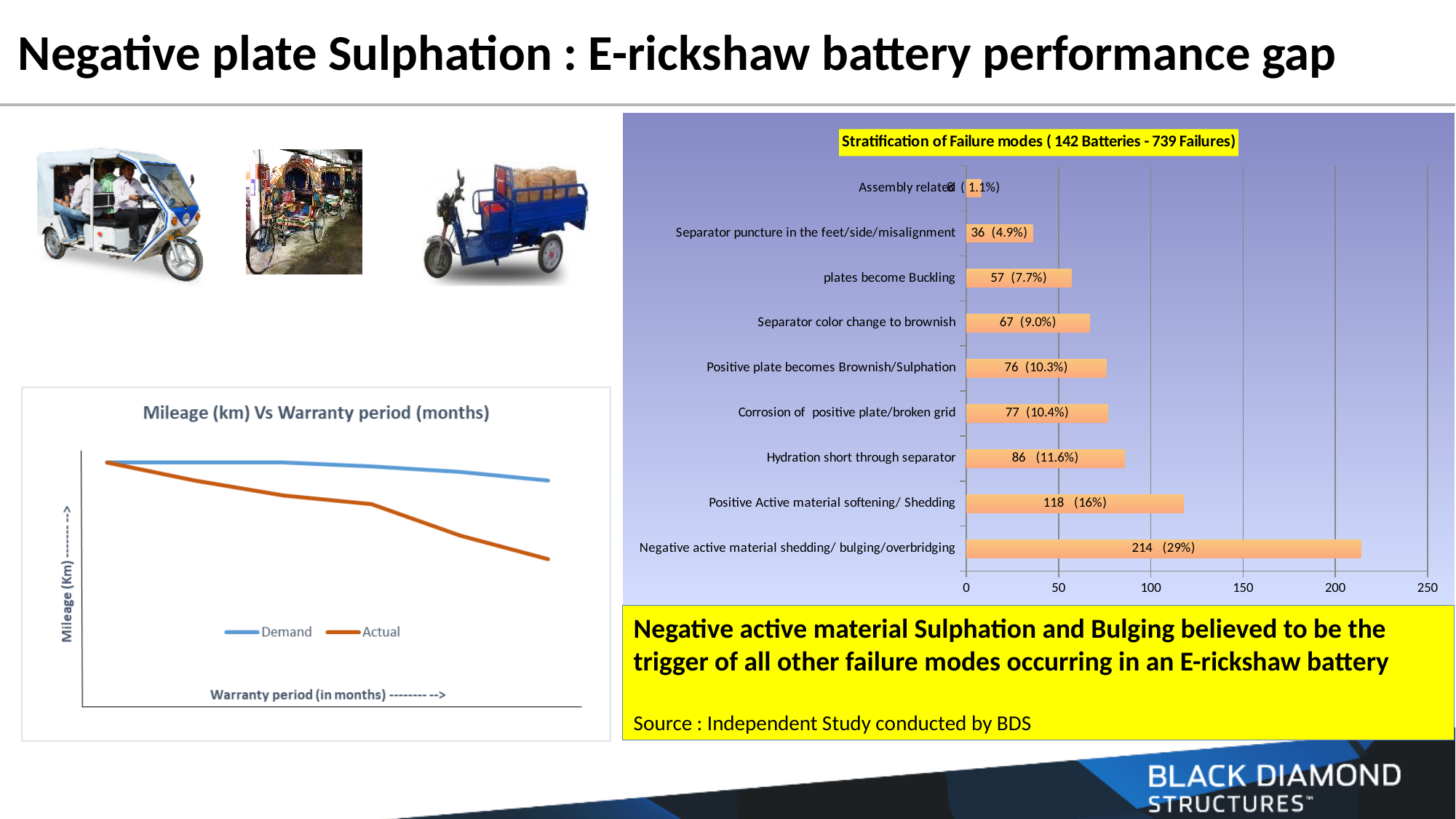
How many failure modes are listed in the 'Stratification of Failure modes' chart? 9 In the 'Mileage (km) Vs Warranty period (months)' chart, does the Actual line rise or fall as the warranty period increases? Fall What kind of chart is the 'Stratification of Failure modes' chart? Bar chart In the 'Stratification of Failure modes' chart, how many failures are shown for Hydration short through separator? 86 In the 'Stratification of Failure modes' chart, is the value for Positive Active material softening/ Shedding greater or less than 100? greater How many series does the legend of the 'Mileage (km) Vs Warranty period (months)' chart list? 2 In the 'Stratification of Failure modes' chart, what is the difference in failures between Negative active material shedding/ bulging/overbridging and Positive Active material softening/ Shedding? 96 In the 'Stratification of Failure modes' chart, which has more failures: Separator color change to brownish or plates become Buckling? Separator color change to brownish In the 'Stratification of Failure modes' chart, which failure mode has the lowest number of failures? Assembly related In the 'Stratification of Failure modes' chart, what percentage is shown for Positive Active material softening/ Shedding? 16% In the 'Stratification of Failure modes' chart, which failure mode has the highest number of failures? Negative active material shedding/ bulging/overbridging In the 'Stratification of Failure modes' chart, how many failures are attributed to Negative active material shedding/ bulging/overbridging? 214